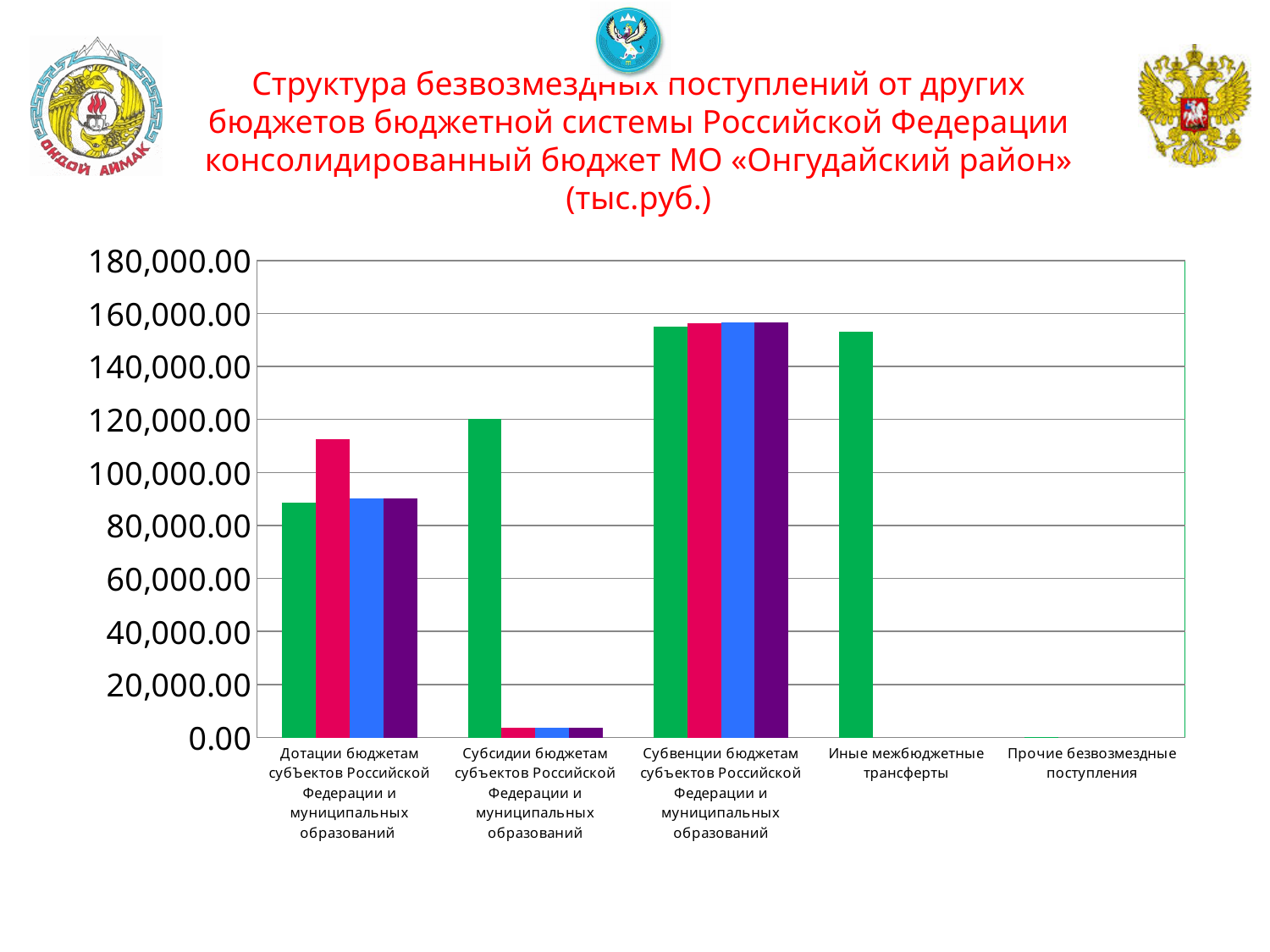
What kind of chart is shown on the slide? bar chart How many categories are shown along the x axis of the chart? 5 Which is larger: the red bar for «Дотации бюджетам...» or the red bar for «Субсидии бюджетам...»? Дотации бюджетам субъектов Российской Федерации и муниципальных образований Is the red bar for «Дотации бюджетам субъектов Российской Федерации и муниципальных образований» greater or less than 100,000.00? greater Which category has the tallest red bar? Субвенции бюджетам субъектов Российской Федерации и муниципальных образований Is the red bar for «Субсидии бюджетам субъектов Российской Федерации и муниципальных образований» greater or less than 20,000.00? less Is the green bar for «Иные межбюджетные трансферты» greater or less than 140,000.00? greater What is the highest value shown on the vertical axis of the chart? 180,000.00 Which is larger: the green bar for «Дотации бюджетам...» or the green bar for «Субсидии бюджетам...»? Субсидии бюджетам субъектов Российской Федерации и муниципальных образований What unit is given in parentheses in the chart title? тыс.руб.